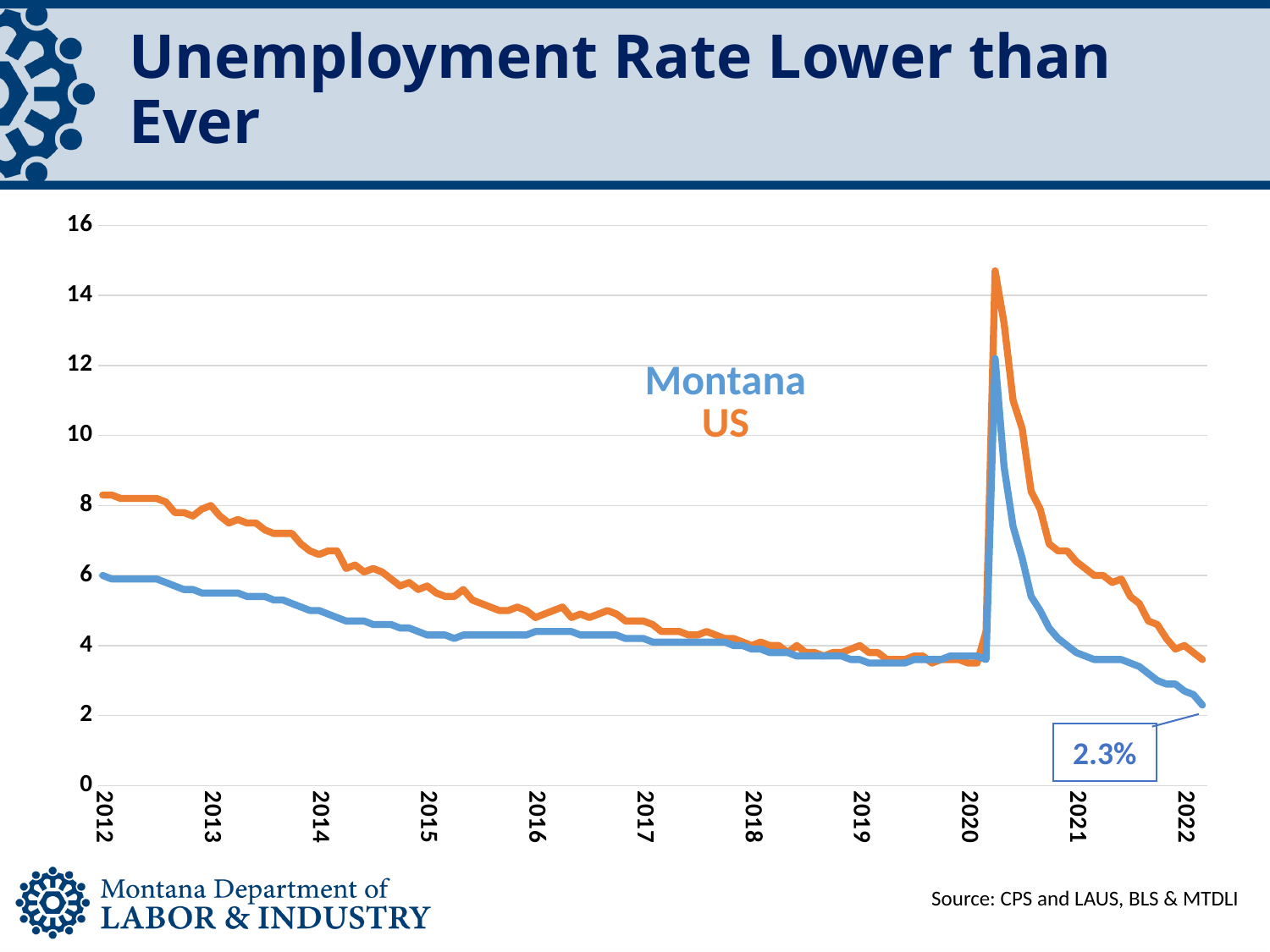
Is the peak value of the US line in 2020 greater or less than 14? greater Is the US value at the start of 2012 greater or less than 6? greater Which series reaches the higher peak in 2020? US What colour is the Montana line? blue Is the US value at the end of 2022 greater or less than 4? less What is the labelled value for Montana at the end of the series in 2022? 2.3% How many series are plotted on the chart? 2 What kind of chart is shown on the slide? line chart How many year labels are shown on the x axis? 11 At the start of 2012, which series has the higher unemployment rate, Montana or US? US From 2012 to 2019, does the US unemployment rate rise or fall? fall